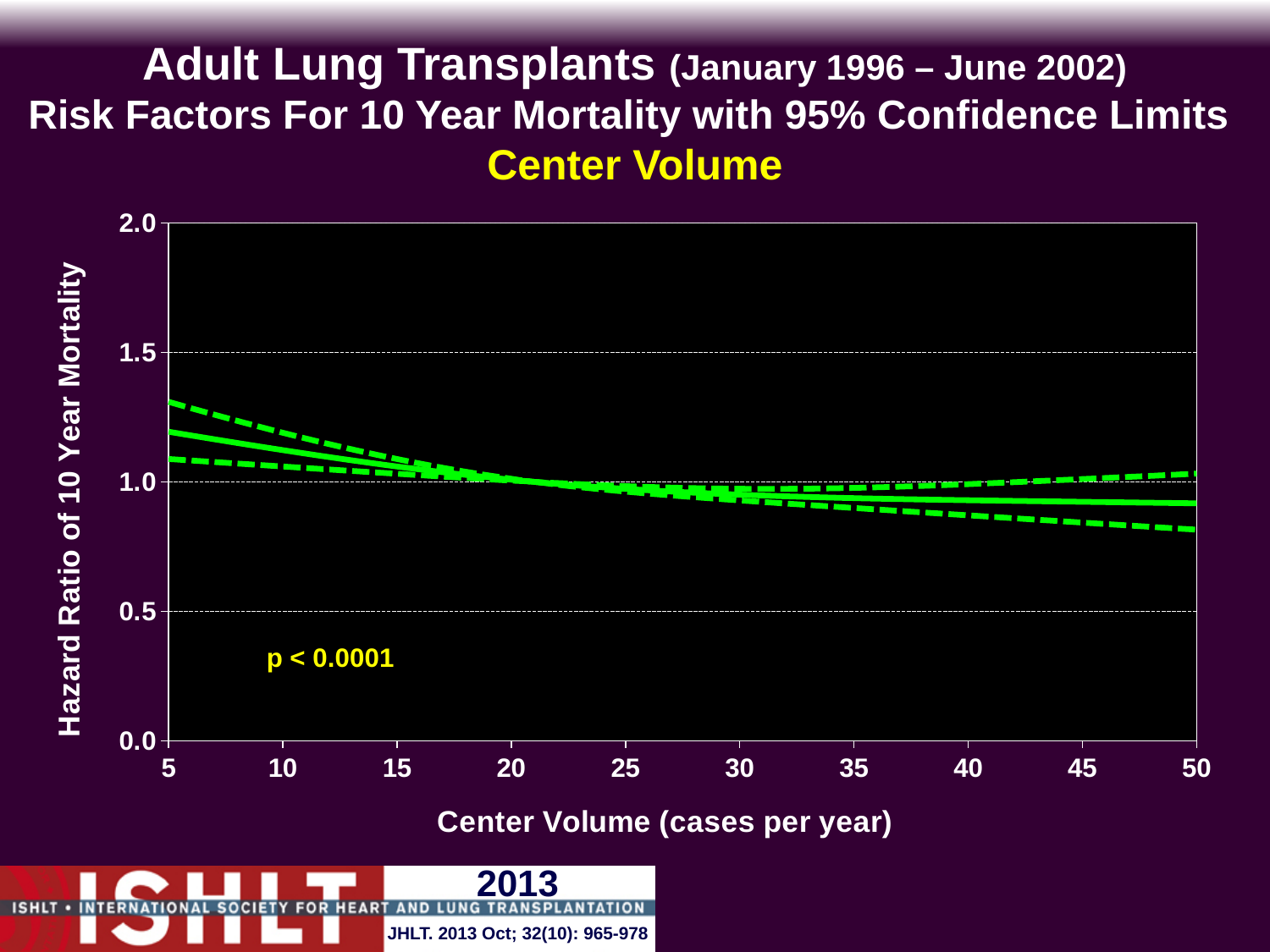
What is the label of the x axis? Center Volume (cases per year) Is the hazard ratio (solid line) at a center volume of 50 cases per year greater or less than 1.0? less Which center volume has the larger hazard ratio on the solid line: 5 or 50 cases per year? 5 Does the hazard ratio of 10 year mortality rise or fall as center volume increases from 5 to 50 cases per year? fall What p-value is printed on the chart? p < 0.0001 Is the hazard ratio (solid line) at a center volume of 5 cases per year greater or less than 1.0? greater Is the lower 95% confidence limit at a center volume of 50 cases per year greater or less than 0.5? greater How many lines are plotted on the chart? 3 What kind of chart is shown on the slide? line chart